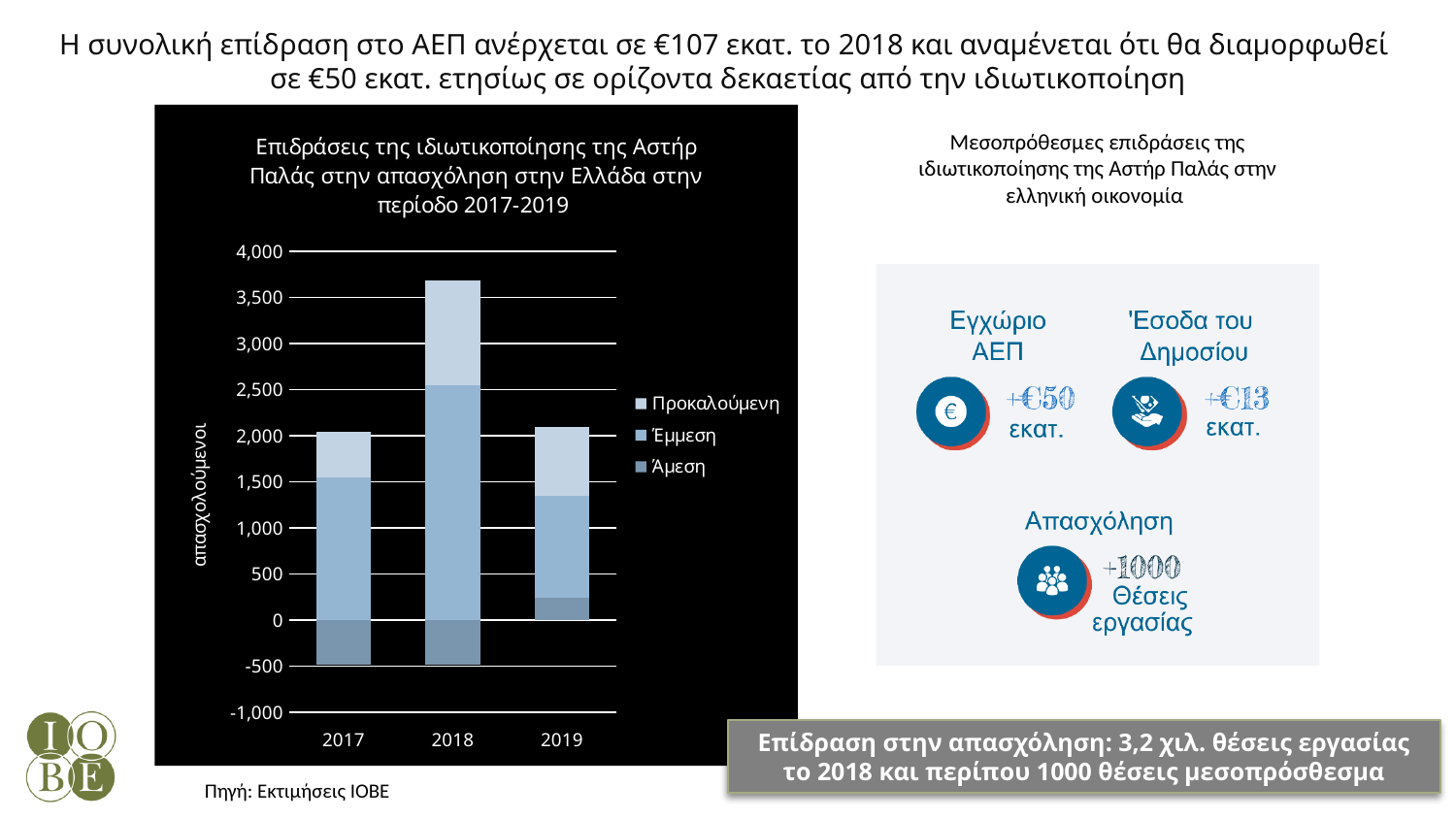
How many series does the chart's legend list? 3 What kind of chart is shown on the slide? Stacked bar chart What is the label on the vertical axis of the chart? απασχολούμενοι Which stacked bar reaches higher, 2017 or 2018? 2018 Is the top of the stacked bar for 2018 greater or less than 3,500? greater Is the Άμεση value for 2017 greater or less than 0? less Is the Άμεση value for 2019 greater or less than 0? greater How many years (categories) are shown on the x axis of the chart? 3 What are the three series listed in the chart's legend? Προκαλούμενη, Έμμεση, Άμεση Which year has the tallest stacked bar in the chart? 2018